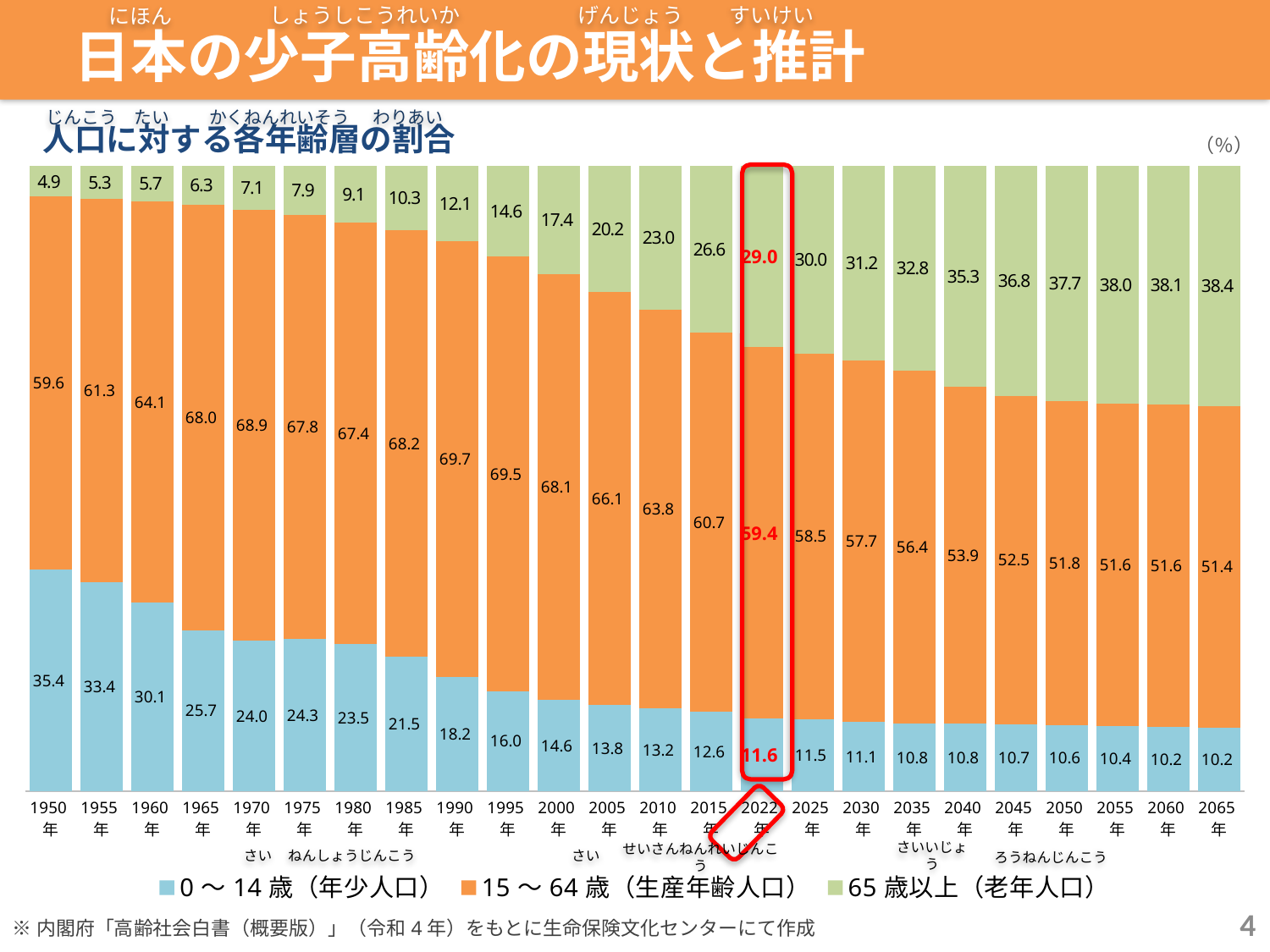
What is the total of the three segments in the 2022年 bar? 100.0 What is the value for 15～64歳（生産年齢人口） in 2065年? 51.4 In which year is the 65歳以上（老年人口） share highest? 2065年 How does the 0～14歳（年少人口） share change from 1950年 to 2065年? falls What is the difference between the 15～64歳（生産年齢人口） value in 1990年 and in 2022年? 10.3 How many series does the legend list? 3 What type of chart is shown on the slide? stacked bar chart How many year categories are plotted along the x axis? 24 In which year is the 0～14歳（年少人口） share highest? 1950年 What is the value for 65歳以上（老年人口） in 2022年? 29.0 Which is larger in 2015年: the 0～14歳（年少人口） value or the 65歳以上（老年人口） value? 65歳以上（老年人口） What is the value for 0～14歳（年少人口） in 1950年? 35.4